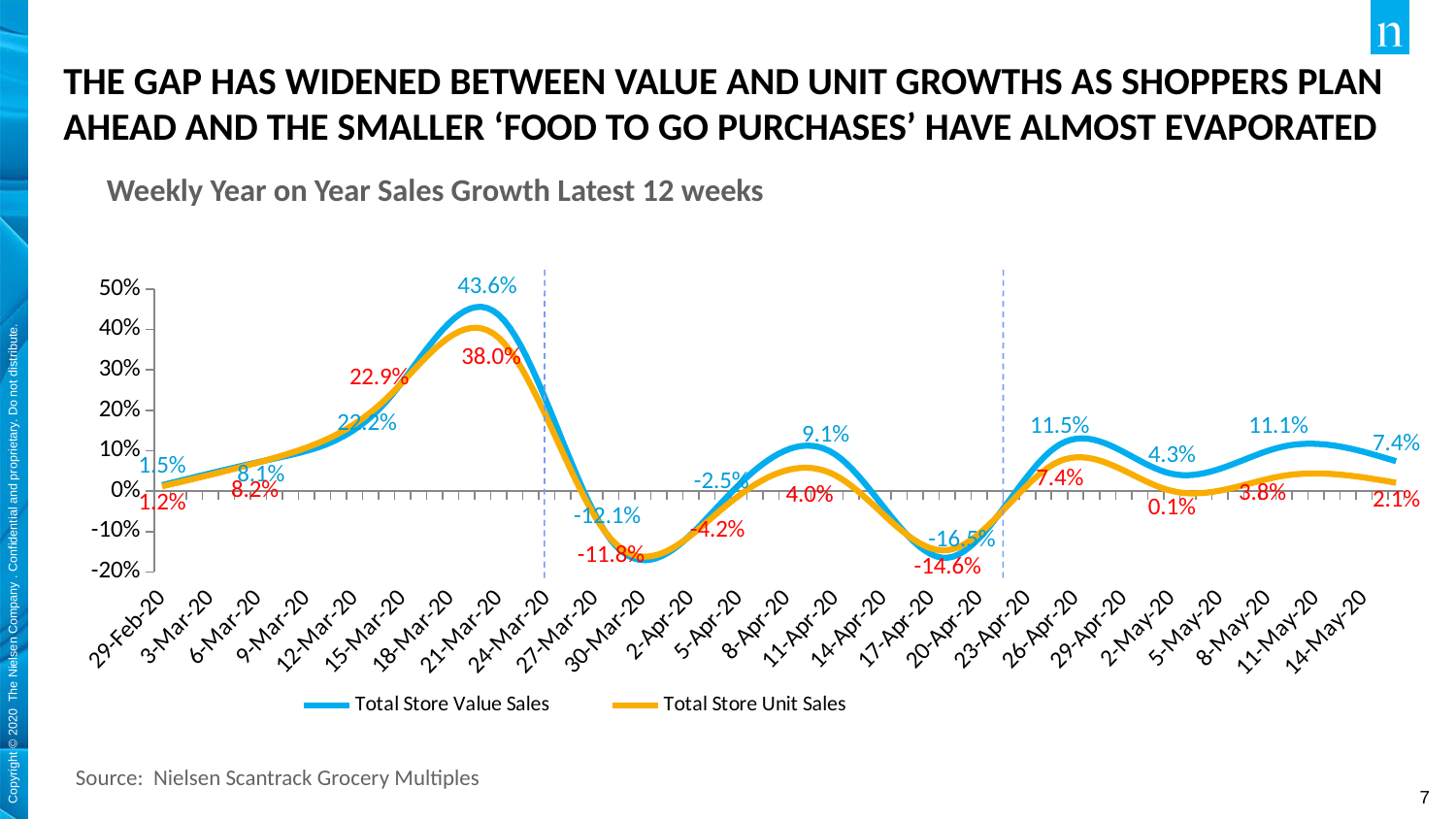
How many series does the legend list? 2 What is the lowest value labelled for Total Store Unit Sales? -14.6% What is the lowest value labelled for Total Store Value Sales? -16.5% What colour is the Total Store Unit Sales line? orange At the last point on the chart, which series is higher: Total Store Value Sales (7.4%) or Total Store Unit Sales (2.1%)? Total Store Value Sales What is the title of the chart? Weekly Year on Year Sales Growth Latest 12 weeks How many data labels are shown for the Total Store Value Sales series? 12 What is the difference between the final labelled values of Total Store Value Sales (7.4%) and Total Store Unit Sales (2.1%)? 5.3 percentage points What kind of chart is shown on the slide? line chart What is the highest value labelled for Total Store Value Sales? 43.6% What is the difference between the peak values of Total Store Value Sales (43.6%) and Total Store Unit Sales (38.0%)? 5.6 percentage points What is the highest value labelled for Total Store Unit Sales? 38.0%